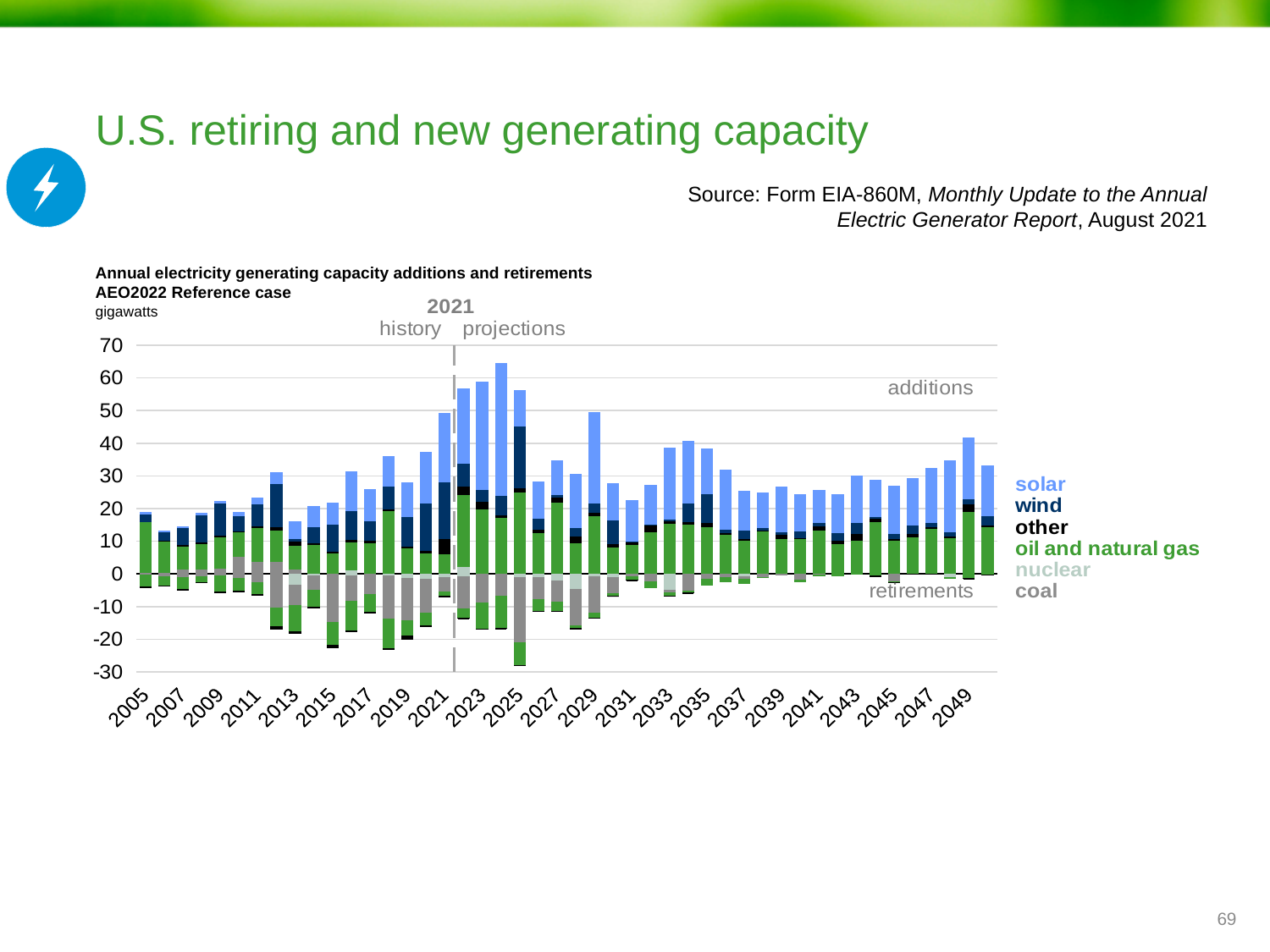
What is the first year and the last year shown on the x axis? 2005 and 2049 Which year has larger retirements, 2013 or 2041? 2013 What unit is the vertical axis measured in? gigawatts What kind of chart is shown on the slide? stacked bar chart Are the total additions for 2024 greater or less than 60 gigawatts? greater Which year has the highest total capacity additions? 2024 Which year has the largest capacity retirements (most negative bar)? 2025 Which year does the dashed line separating history from projections mark? 2021 Are the total additions for 2021 greater or less than 40 gigawatts? greater Which year has larger total additions, 2024 or 2021? 2024 How many series does the legend list? 6 Are the total additions for 2005 greater or less than 30 gigawatts? less